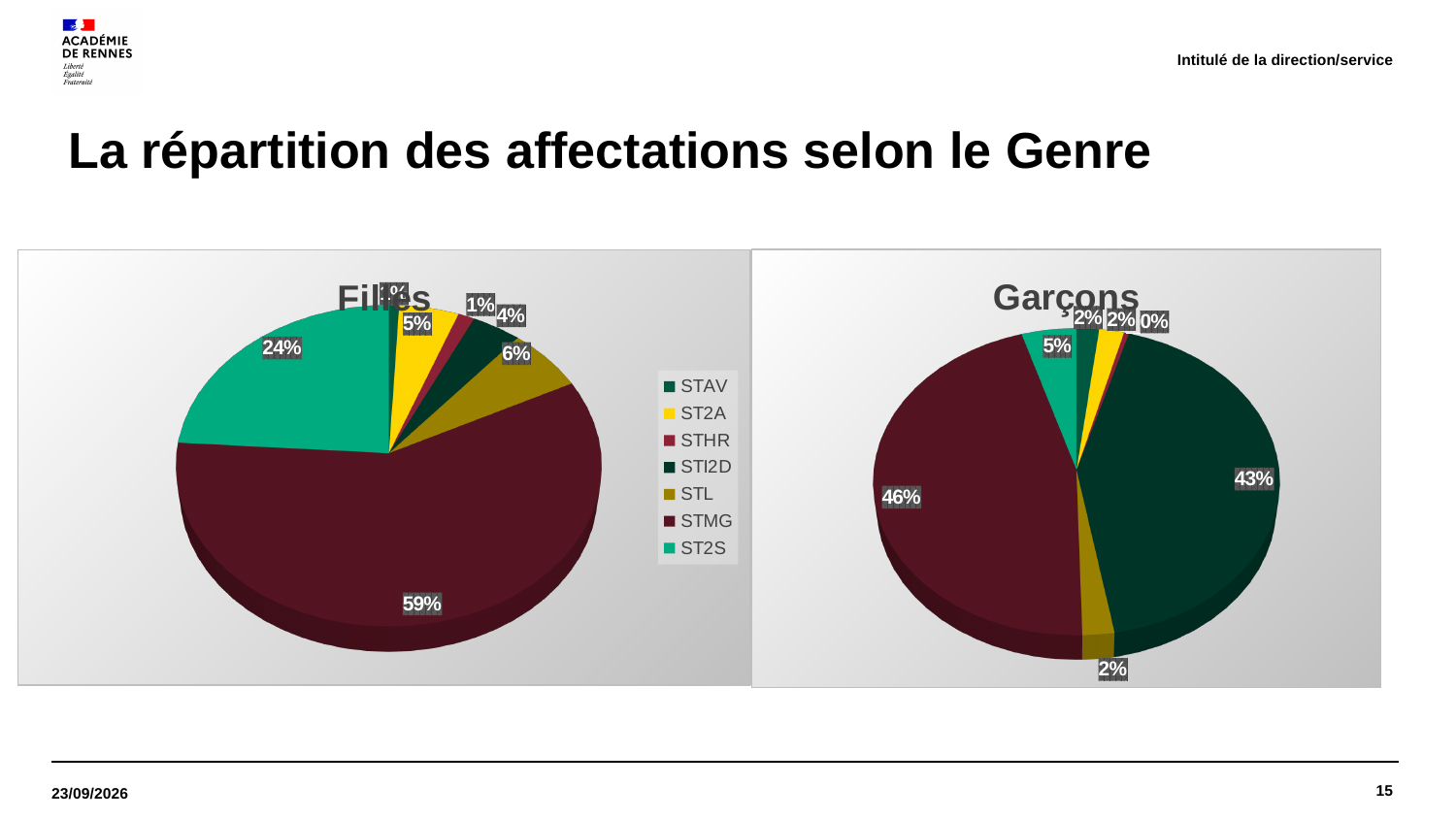
In the Garçons chart, what share does ST2S have? 5% In the Filles chart, what share does ST2S have? 24% In the Garçons chart, which category has the largest share? STMG In the Filles chart, what is the difference between the STMG share and the ST2S share? 35 percentage points What are the titles of the two pie charts? Filles and Garçons How many categories does the legend list? 7 In the Filles chart, what share does STMG have? 59% Which is larger: the STI2D share in the Filles chart or the STI2D share in the Garçons chart? Garçons In the Garçons chart, what share does STI2D have? 43% In the Garçons chart, what share does STMG have? 46% In the Filles chart, which category has the largest share? STMG What kind of charts are shown on the slide? Pie charts